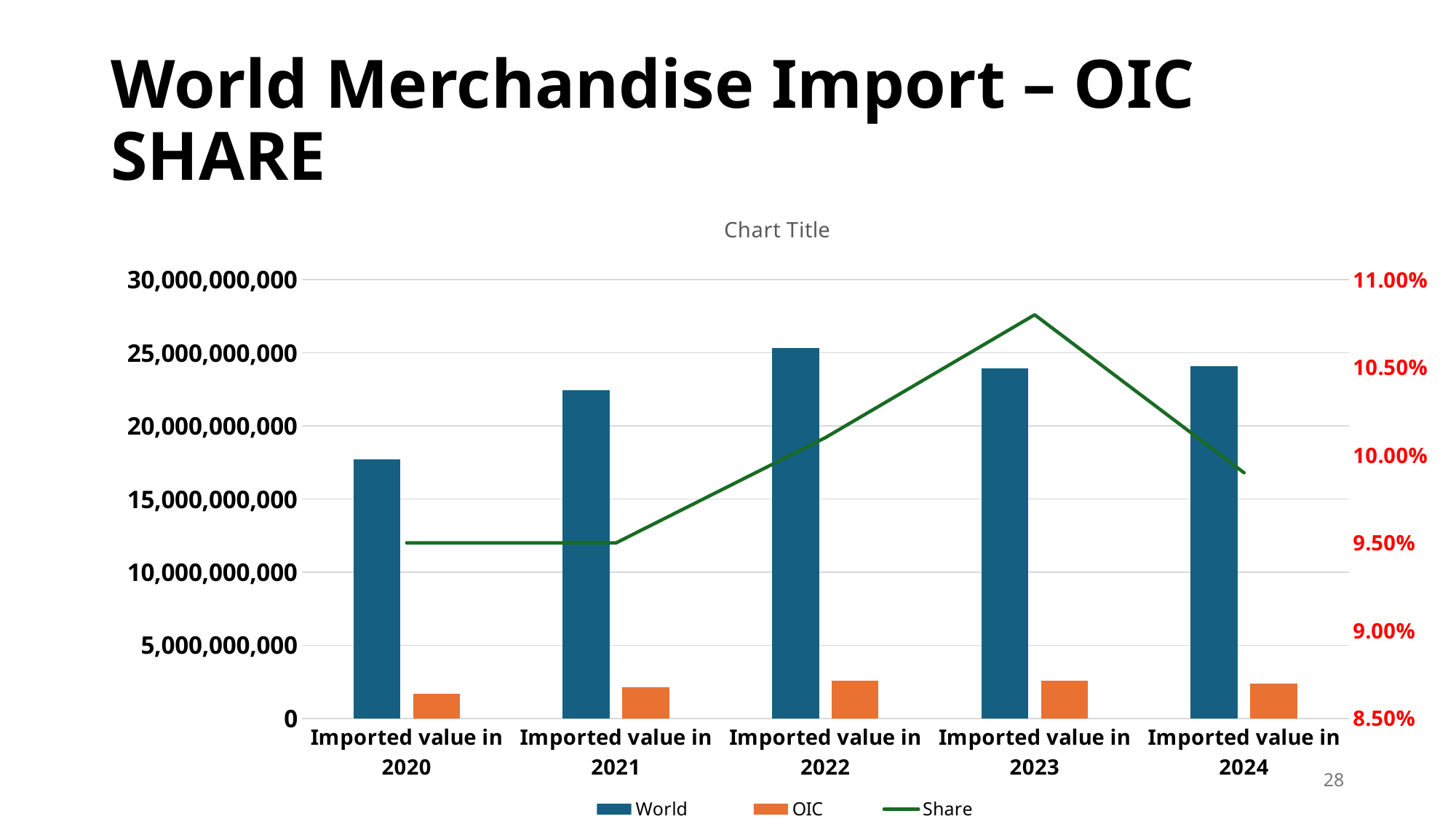
In which year does the Share line reach its highest point? Imported value in 2023 In which year is the World imported value lowest? Imported value in 2020 How many series does the legend list? 3 In which year is the OIC imported value lowest? Imported value in 2020 How many year categories are shown on the x axis? 5 What title is printed above the chart? Chart Title In which year is the World imported value highest? Imported value in 2022 Does the World imported value rise or fall from 2020 to 2022? rise What kind of chart is this? Combined bar and line chart Is the Share value in 2023 greater or less than 10.50%? greater Is the World imported value in 2020 greater or less than 20,000,000,000? less